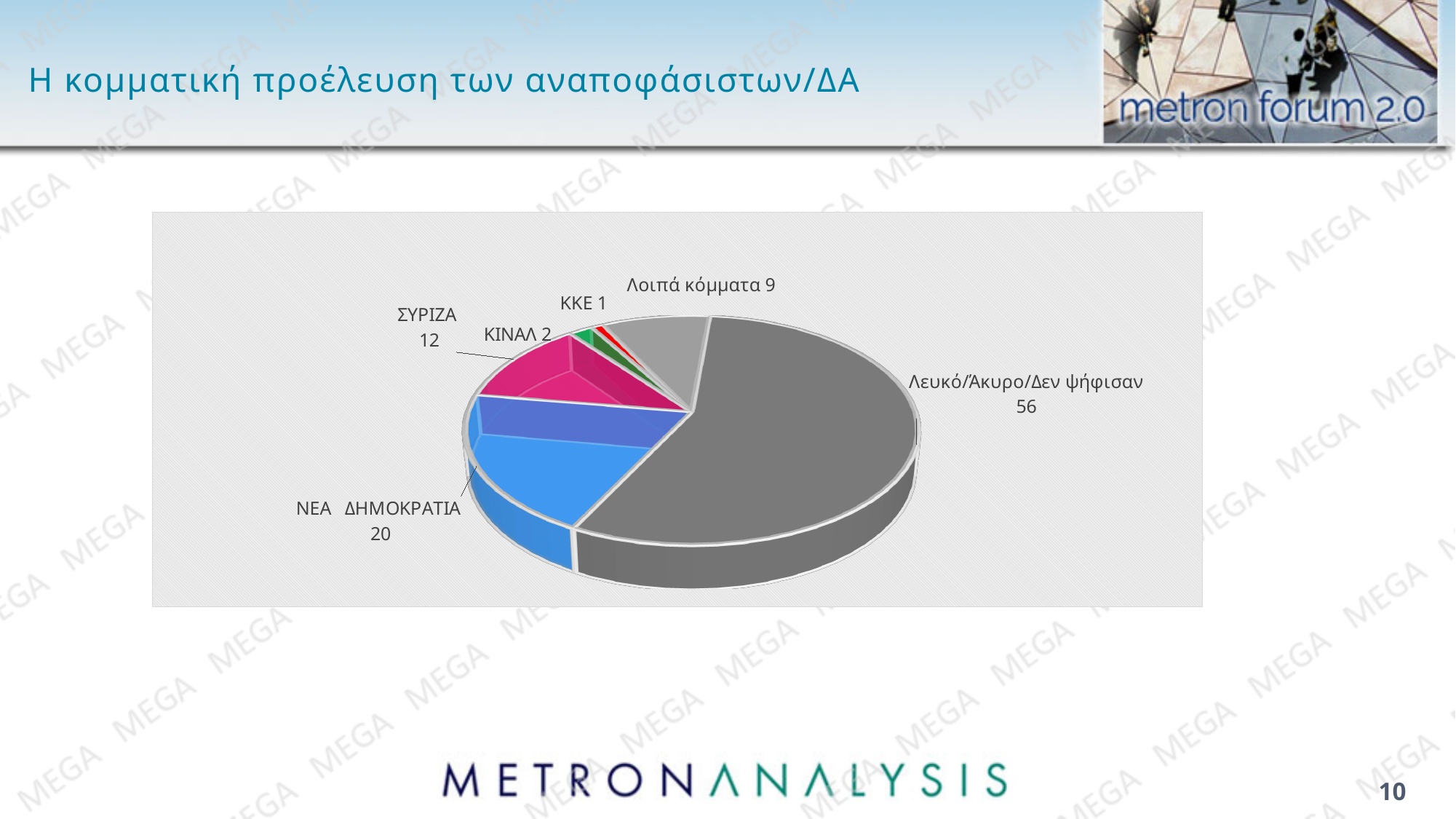
How many slices does the pie chart have? 6 What value is shown for Λοιπά κόμματα in the pie chart? 9 What value is shown for ΝΕΑ ΔΗΜΟΚΡΑΤΙΑ in the pie chart? 20 What is the difference between the values for ΝΕΑ ΔΗΜΟΚΡΑΤΙΑ and ΣΥΡΙΖΑ? 8 What is the title of the slide containing the pie chart? Η κομματική προέλευση των αναποφάσιστων/ΔΑ Which slice of the pie chart has the largest value? Λευκό/Άκυρο/Δεν ψήφισαν Which is larger, the value for ΚΙΝΑΛ or the value for ΚΚΕ? ΚΙΝΑΛ What is the difference between the values for Λευκό/Άκυρο/Δεν ψήφισαν and ΝΕΑ ΔΗΜΟΚΡΑΤΙΑ? 36 What kind of chart is shown on the slide? Pie chart What value is shown for ΣΥΡΙΖΑ in the pie chart? 12 Which slice of the pie chart has the smallest value? ΚΚΕ What value is shown for Λευκό/Άκυρο/Δεν ψήφισαν in the pie chart? 56